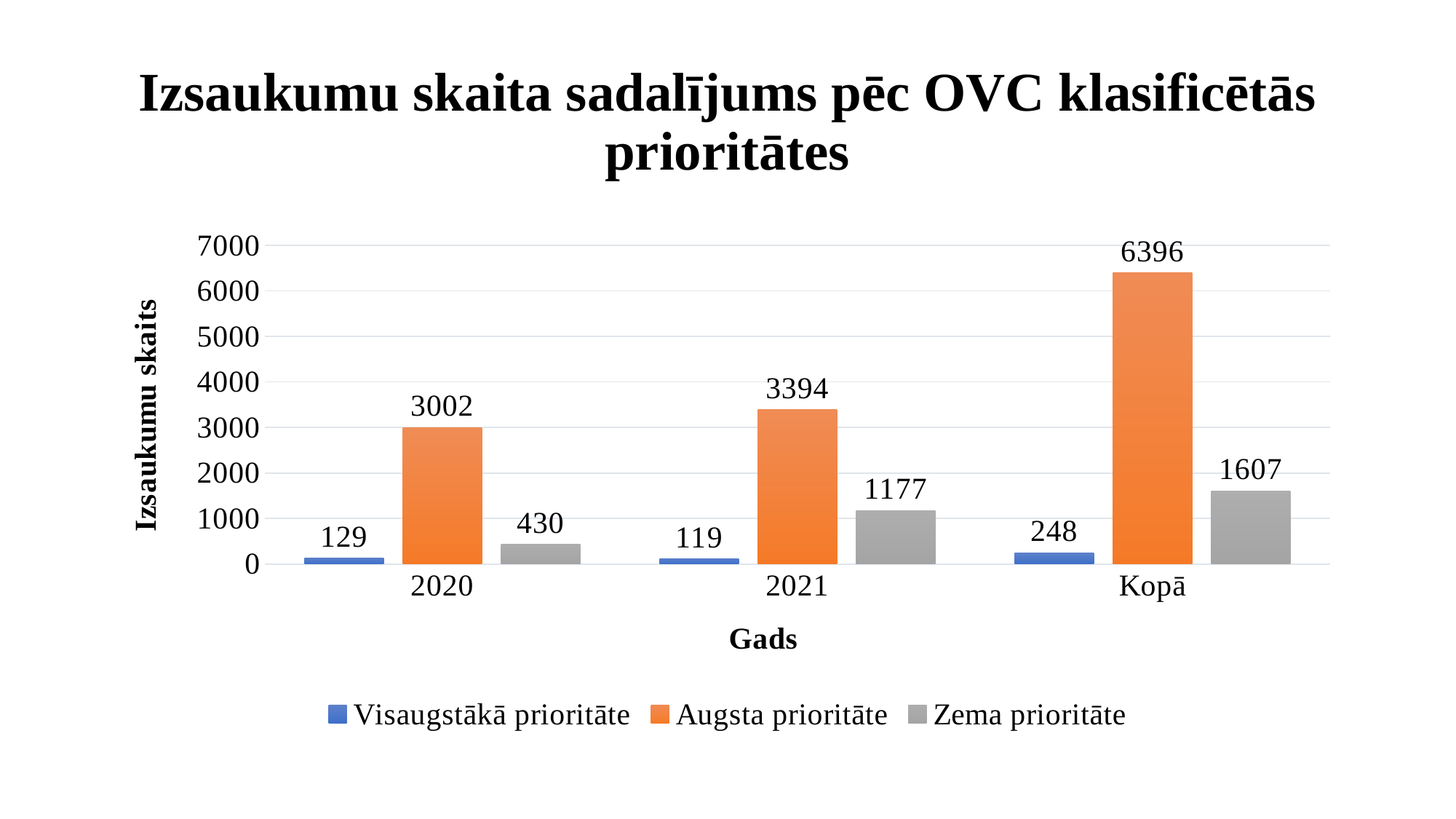
Which category has the lowest value for Visaugstākā prioritāte? 2021 What is the value for Augsta prioritāte in 2020? 3002 How many series does the legend list? 3 How many categories are shown on the x axis? 3 What is the label of the y axis? Izsaukumu skaits Which category has the highest value for Augsta prioritāte? Kopā What is the difference between the Augsta prioritāte values for 2021 and 2020? 392 What kind of chart is shown on the slide? bar chart What is the value for Visaugstākā prioritāte in the Kopā category? 248 What is the value for Zema prioritāte in 2021? 1177 Is the value for Augsta prioritāte in Kopā greater or less than 6000? greater Which is larger: Zema prioritāte in 2020 or Zema prioritāte in 2021? Zema prioritāte in 2021